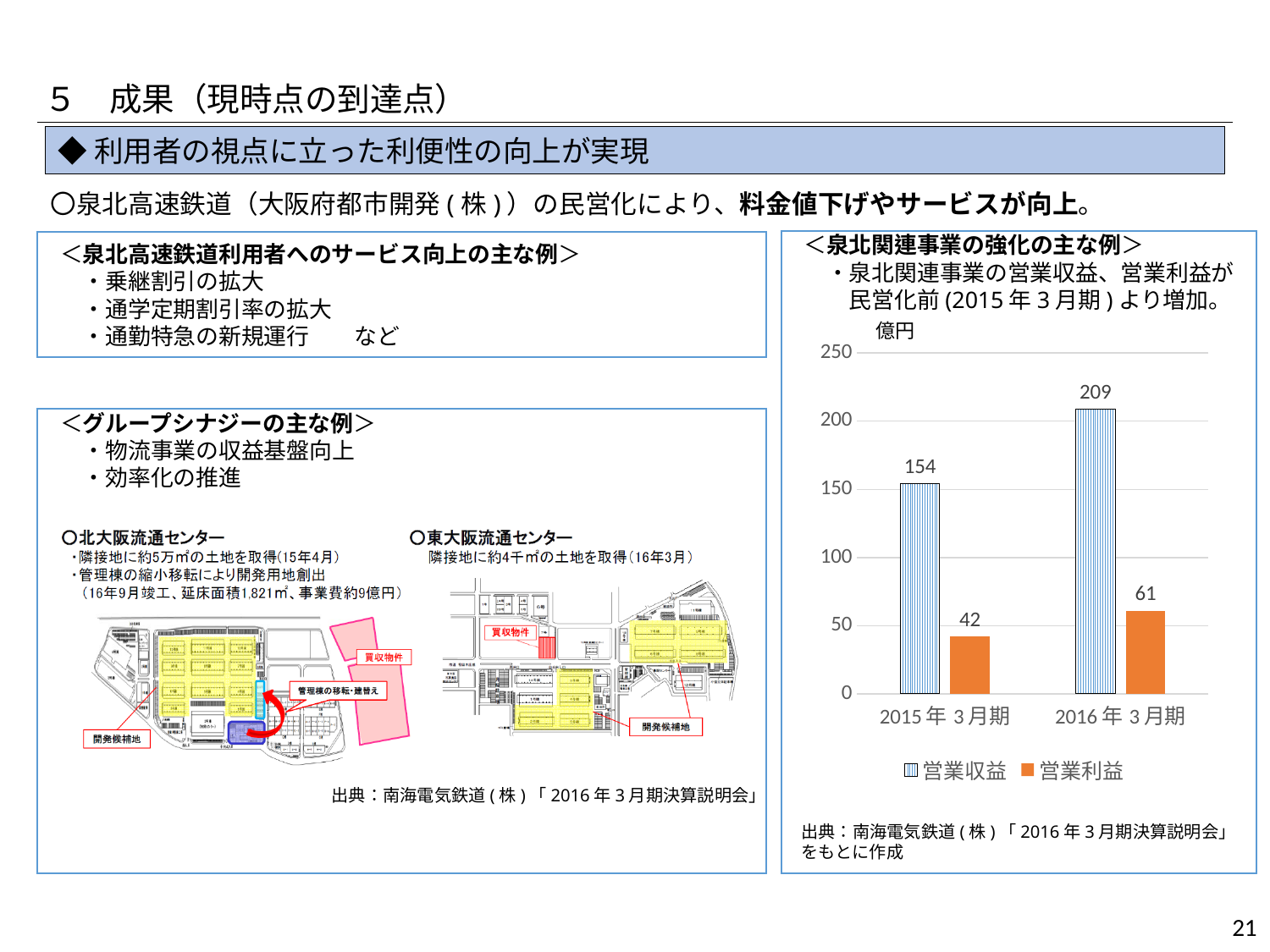
What is the 営業利益 value for 2016年3月期? 61 What type of chart is shown on the slide? bar chart Which bar in the chart has the lowest value? 営業利益 for 2015年3月期 What is the 営業収益 value for 2015年3月期? 154 Is 営業利益 for 2016年3月期 larger or smaller than 営業利益 for 2015年3月期? larger What is the 営業利益 value for 2015年3月期? 42 By how much did 営業収益 increase from 2015年3月期 to 2016年3月期? 55 What unit is shown at the top of the chart's vertical axis? 億円 What is the 営業収益 value for 2016年3月期? 209 Which period has the higher 営業収益? 2016年3月期 How many series does the legend list? 2 What is the difference between 営業収益 and 営業利益 in 2016年3月期? 148